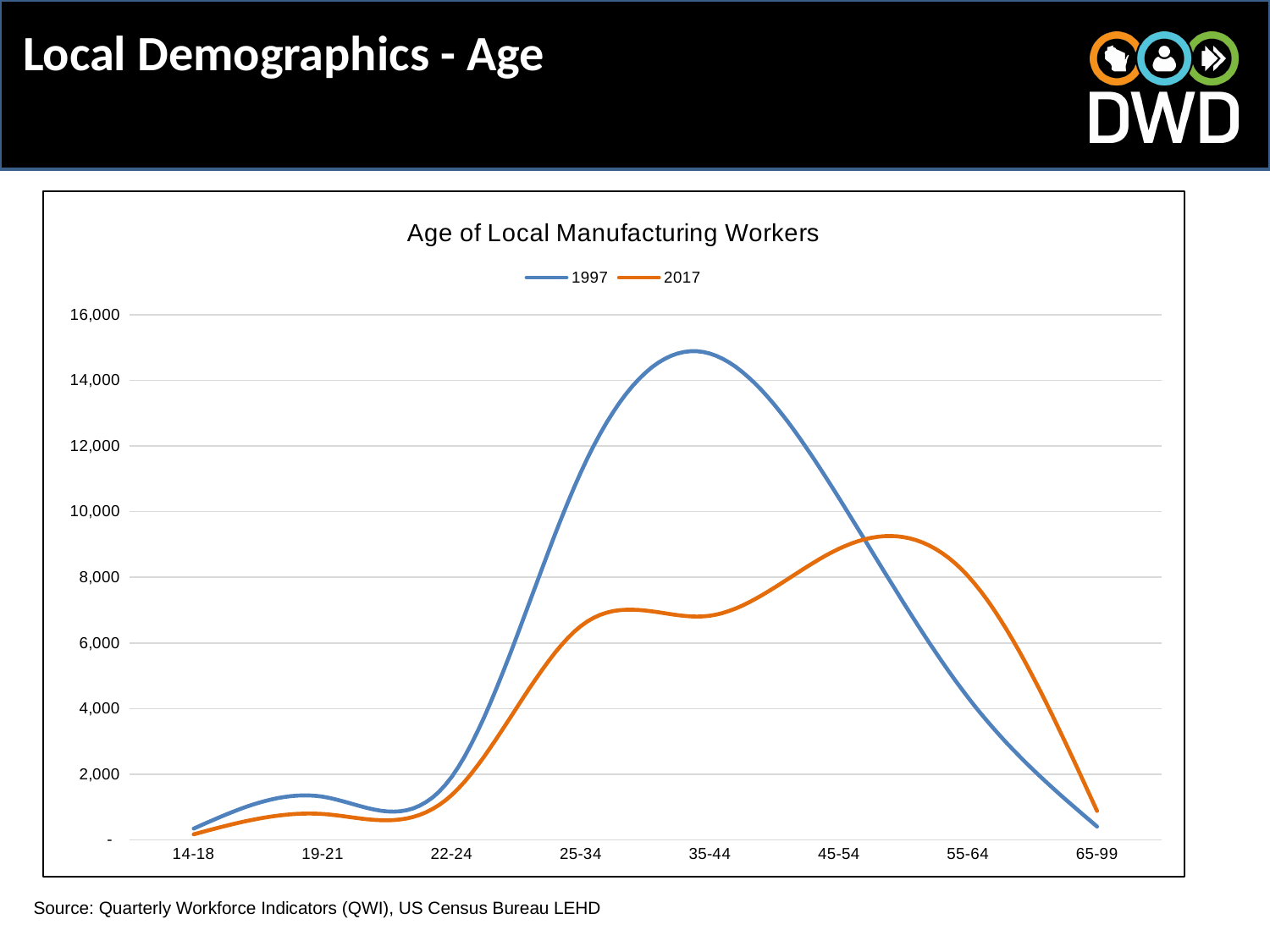
Is the 1997 value for the 65-99 age group greater or less than 2,000? less What is the title of the chart? Age of Local Manufacturing Workers Is the 2017 value for the 45-54 age group greater or less than 8,000? greater How many series does the legend list? 2 Is the 2017 value for the 35-44 age group greater or less than 8,000? less Which age group has the highest value for the 1997 series? 35-44 Does the 1997 line rise or fall from the 35-44 age group to the 65-99 age group? fall For the 35-44 age group, which series has the larger value, 1997 or 2017? 1997 For the 55-64 age group, which series has the larger value, 1997 or 2017? 2017 What type of chart is shown on the slide? line chart How many age categories are shown on the x axis? 8